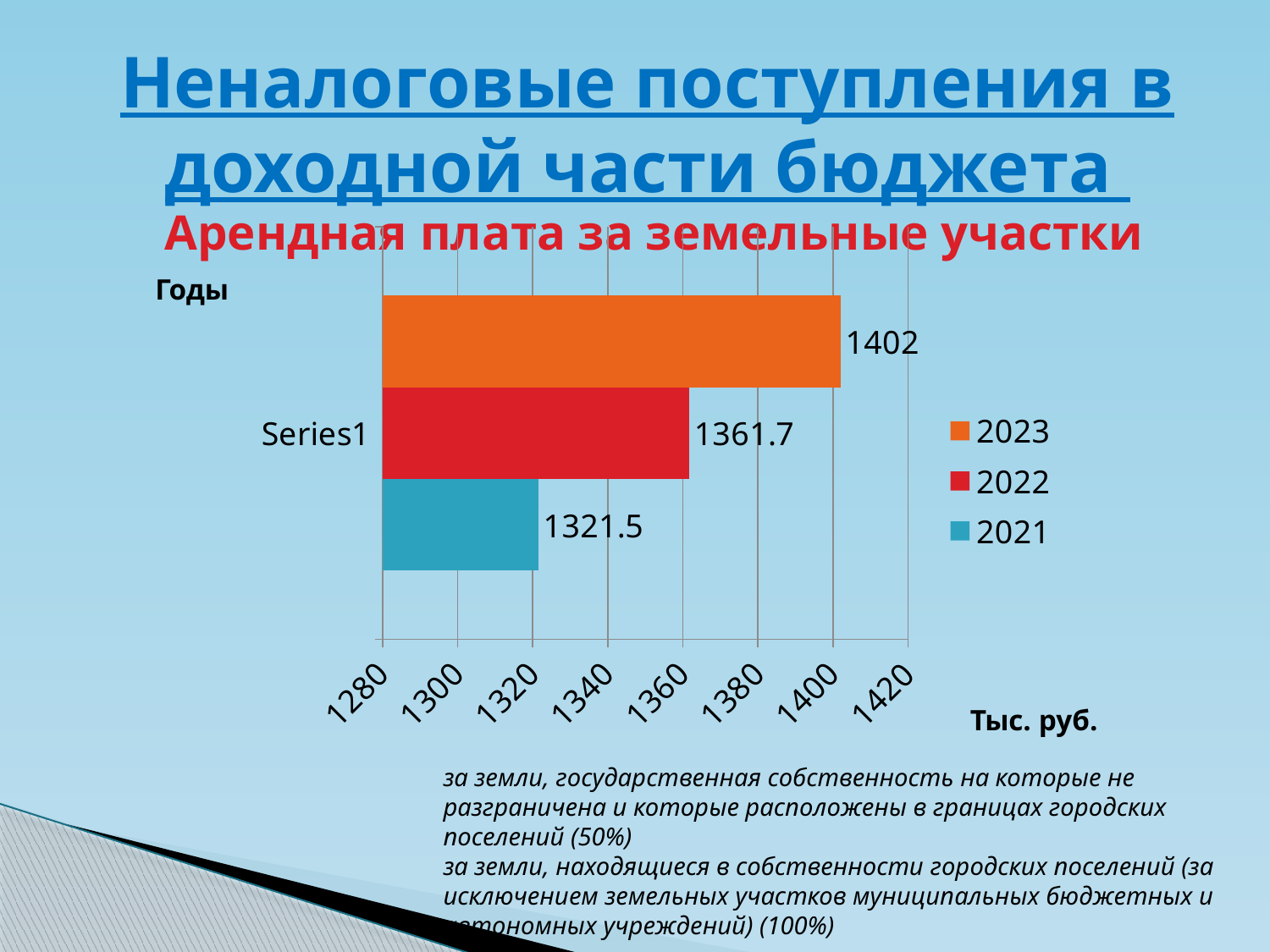
Which year has the highest value? 2023 What is the difference between the values for 2023 and 2022? 40.3 What is the value for 2021? 1321.5 How many series does the legend list? 3 What is the value for 2022? 1361.7 What unit is shown below the horizontal axis of the chart? Тыс. руб. What kind of chart is shown on the slide? bar chart What is the difference between the values for 2022 and 2021? 40.2 Which year has the lowest value? 2021 Which is larger, the value for 2022 or the value for 2021? 2022 Is the value for 2023 greater or less than 1400? greater What is the value for 2023? 1402